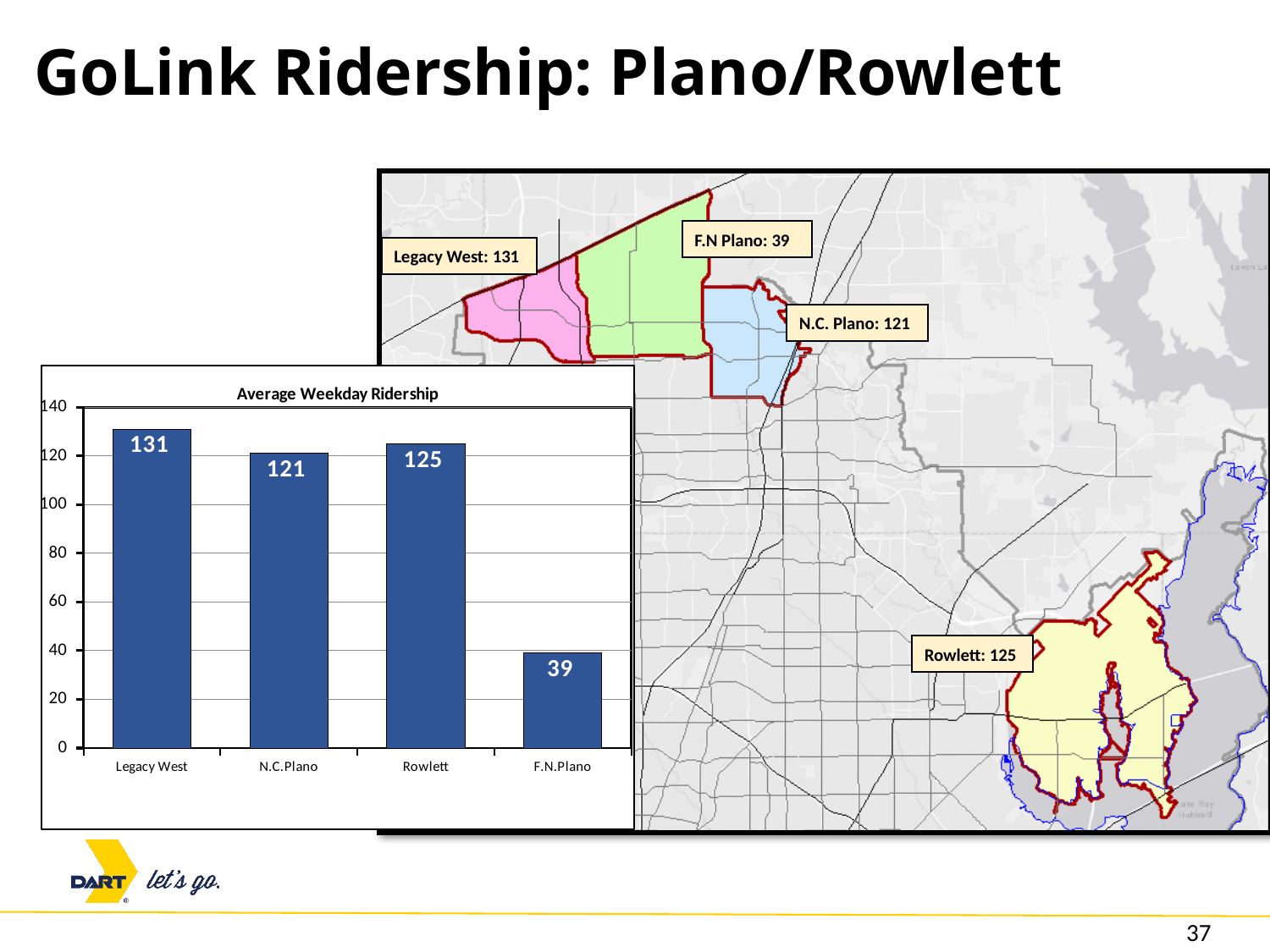
What is the average weekday ridership for F.N.Plano? 39 What is the difference in average weekday ridership between Legacy West and F.N.Plano? 92 Which has higher average weekday ridership, Rowlett or N.C.Plano? Rowlett What is the title of the chart? Average Weekday Ridership Which zone has the lowest average weekday ridership? F.N.Plano What is the difference in average weekday ridership between Rowlett and N.C.Plano? 4 What is the average weekday ridership for N.C.Plano? 121 What is the average weekday ridership for Legacy West? 131 Is the value for F.N.Plano greater or less than 40? less What kind of chart is used to show average weekday ridership? bar chart Which zone has the highest average weekday ridership? Legacy West How many zones are shown in the bar chart? 4